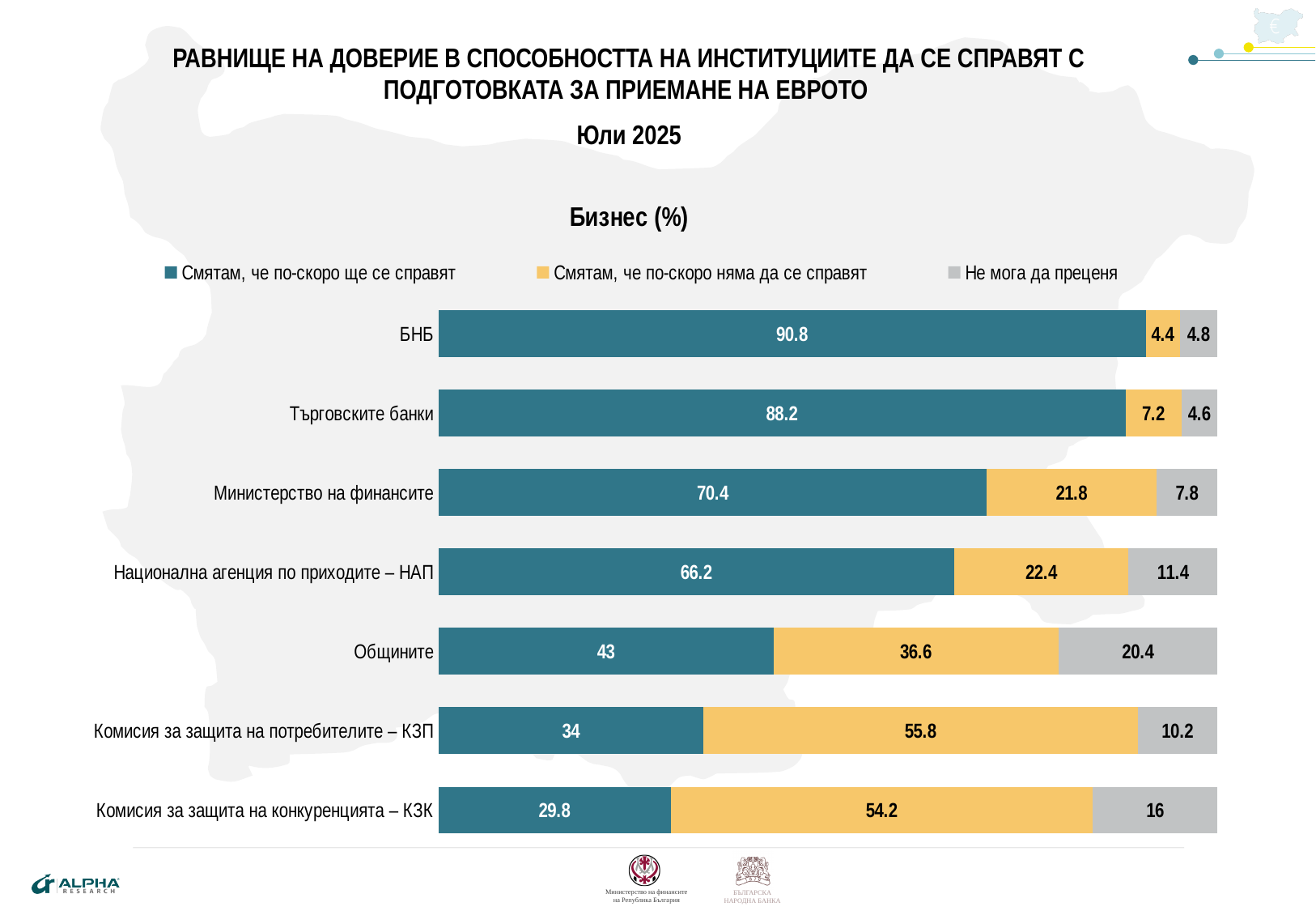
What is the value of "Смятам, че по-скоро ще се справят" for БНБ? 90.8 What is the subtitle shown above the chart? Бизнес (%) What is the total of the stacked bar for Търговските банки? 100 What is the value of "Смятам, че по-скоро няма да се справят" for Общините? 36.6 What is the value of "Не мога да преценя" for Национална агенция по приходите – НАП? 11.4 What is the difference between the "Смятам, че по-скоро ще се справят" values for Министерство на финансите and Общините? 27.4 How many series does the legend list? 3 Which has a larger "Смятам, че по-скоро няма да се справят" value: Комисия за защита на потребителите – КЗП or Комисия за защита на конкуренцията – КЗК? Комисия за защита на потребителите – КЗП How many institutions are shown in the chart? 7 Which institution has the highest value for "Смятам, че по-скоро ще се справят"? БНБ Which institution has the lowest value for "Смятам, че по-скоро ще се справят"? Комисия за защита на конкуренцията – КЗК What kind of chart is shown on the slide? Stacked bar chart